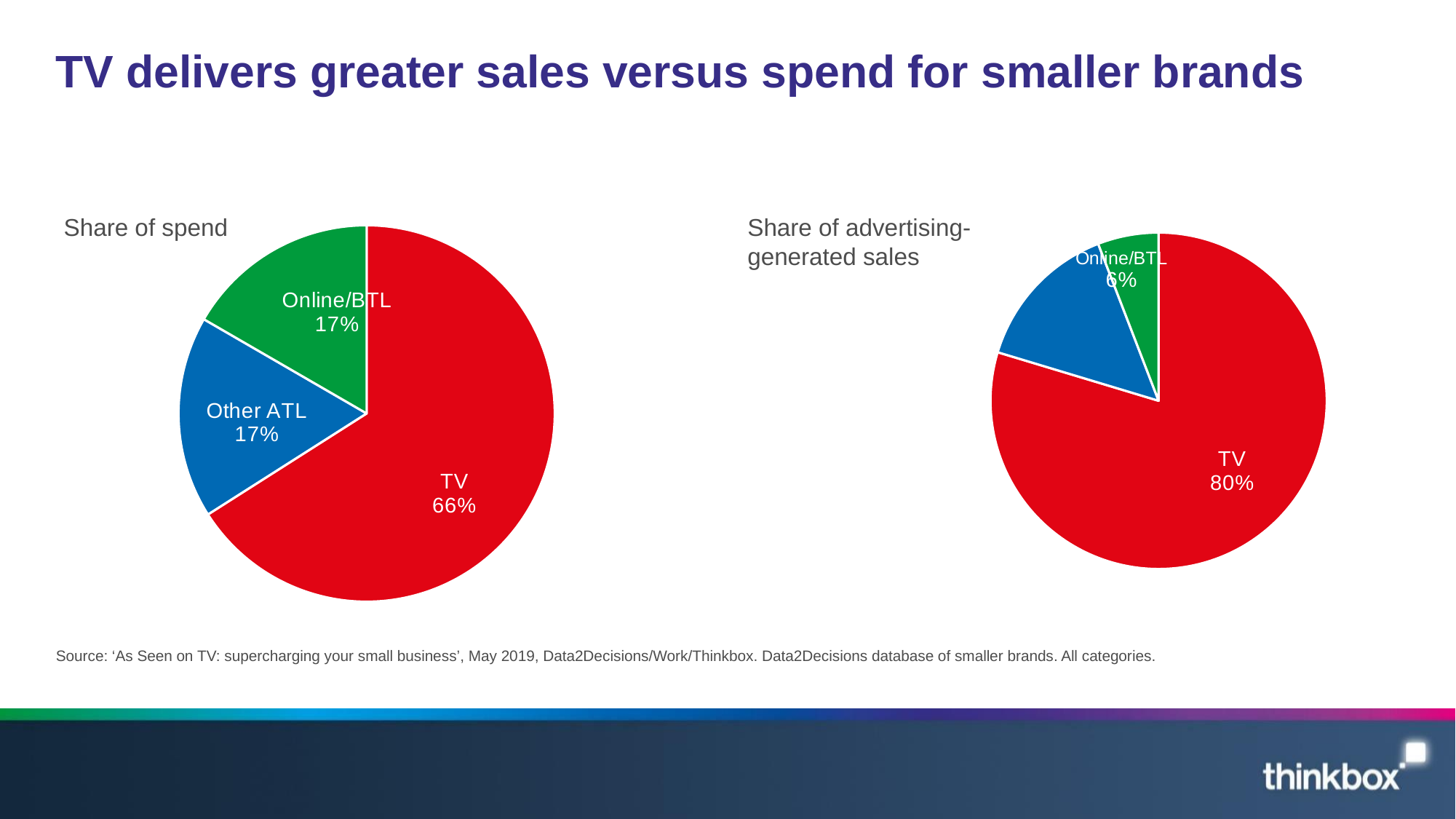
What colour is the TV slice in both pie charts? Red In the 'Share of spend' pie chart, which category has the largest slice? TV How many slices does the 'Share of spend' pie chart have? 3 In the 'Share of advertising-generated sales' pie chart, which labelled category has the smallest slice? Online/BTL In the 'Share of advertising-generated sales' pie chart, what share does TV account for? 80% How many percentage points higher is TV's share in the 'Share of advertising-generated sales' chart than in the 'Share of spend' chart? 14 percentage points What type of chart is used on this slide? Pie chart In the 'Share of spend' pie chart, what is the share for Other ATL? 17% In the 'Share of spend' pie chart, what share does TV account for? 66% What is the difference in percentage points between the Online/BTL share in the 'Share of spend' chart and in the 'Share of advertising-generated sales' chart? 11 percentage points In the 'Share of advertising-generated sales' pie chart, what is the share for Online/BTL? 6% Is the Online/BTL share larger in the 'Share of spend' chart or in the 'Share of advertising-generated sales' chart? Share of spend